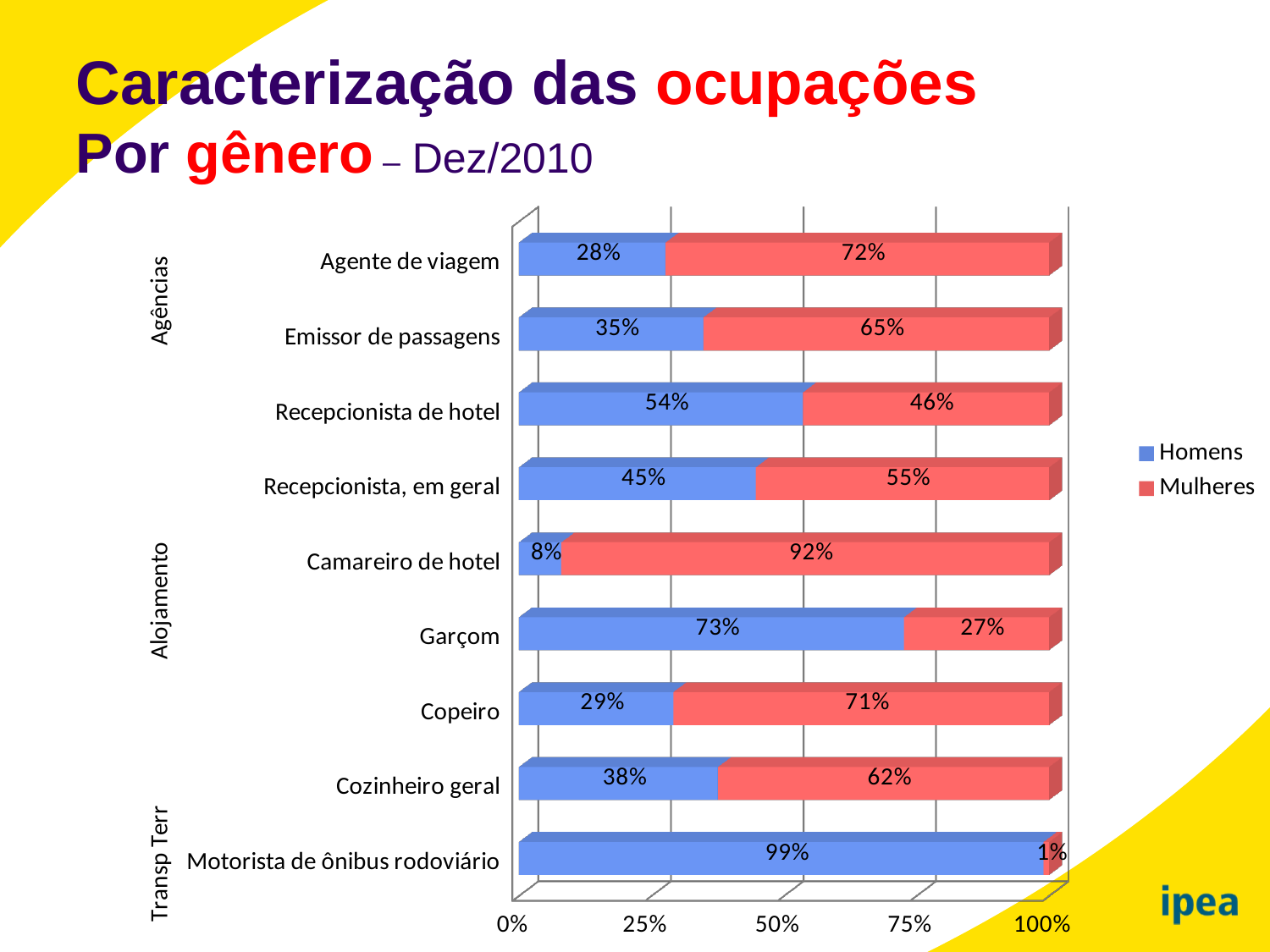
Which occupation has the highest Mulheres share? Camareiro de hotel What is the difference between the Mulheres and Homens values for Copeiro? 42% How many series does the legend list? 2 What is the Mulheres value for Garçom? 27% What is the Homens value for Agente de viagem? 28% What kind of chart is shown on the slide? Stacked bar chart How many occupations are shown on the chart? 9 Which occupation has the lowest Homens share? Camareiro de hotel What is the Mulheres value for Camareiro de hotel? 92% What is the Homens value for Motorista de ônibus rodoviário? 99% What colour represents Mulheres in the chart? Red Which is larger for Recepcionista de hotel, the Homens value or the Mulheres value? Homens